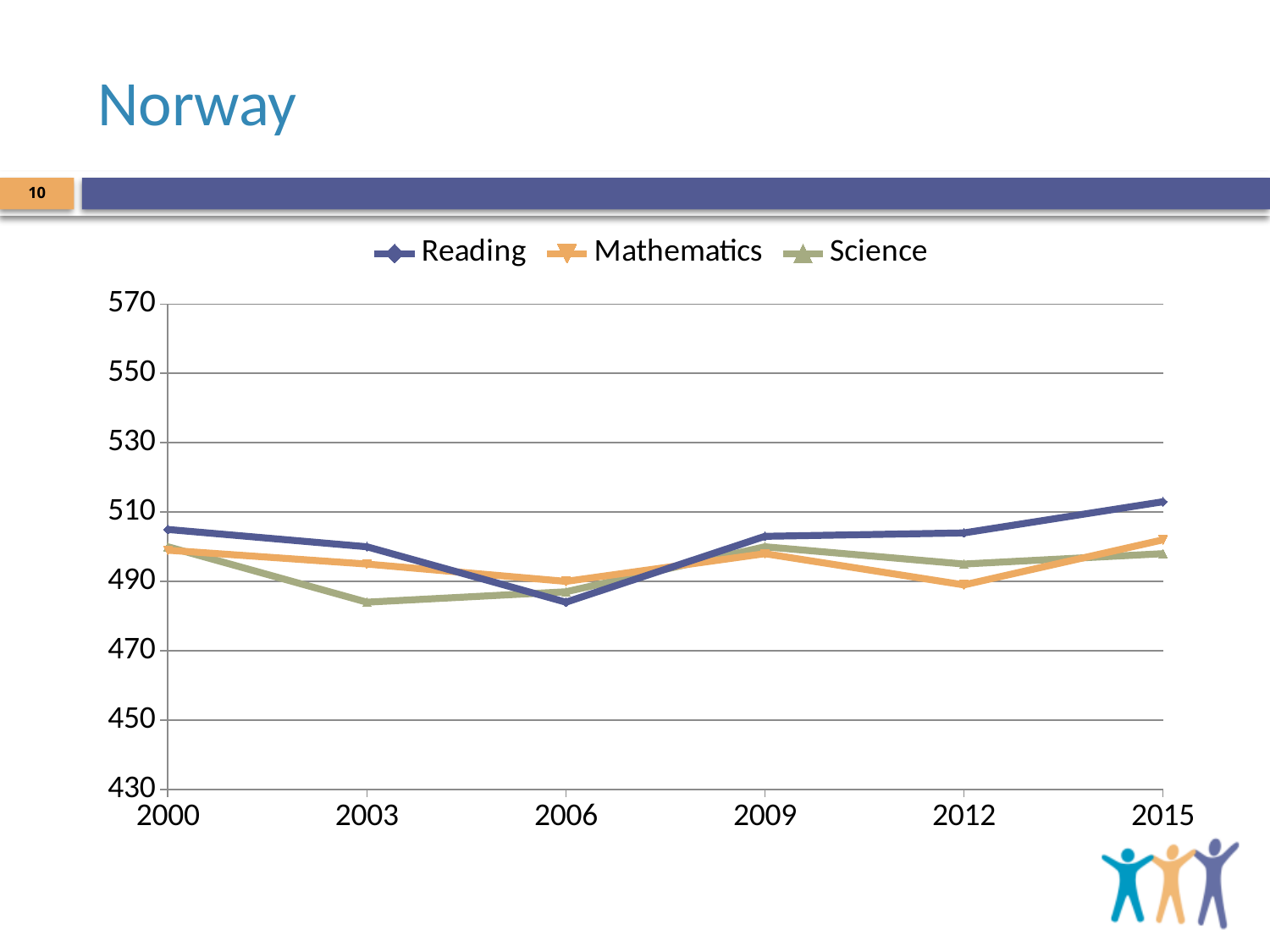
Does the Reading series rise or fall from 2006 to 2015? rise Is the value for Reading in 2006 greater or less than 490? less In which year is the Reading series at its highest? 2015 What is the title of the slide containing the chart? Norway Is the value for Reading in 2015 greater or less than 490? greater How many series does the legend list? 3 In 2012, which is higher, Reading or Mathematics? Reading How many years are plotted along the x axis? 6 Is the value for Mathematics in 2015 greater or less than 490? greater What kind of chart is shown on the slide? line chart In which year is the Reading series at its lowest? 2006